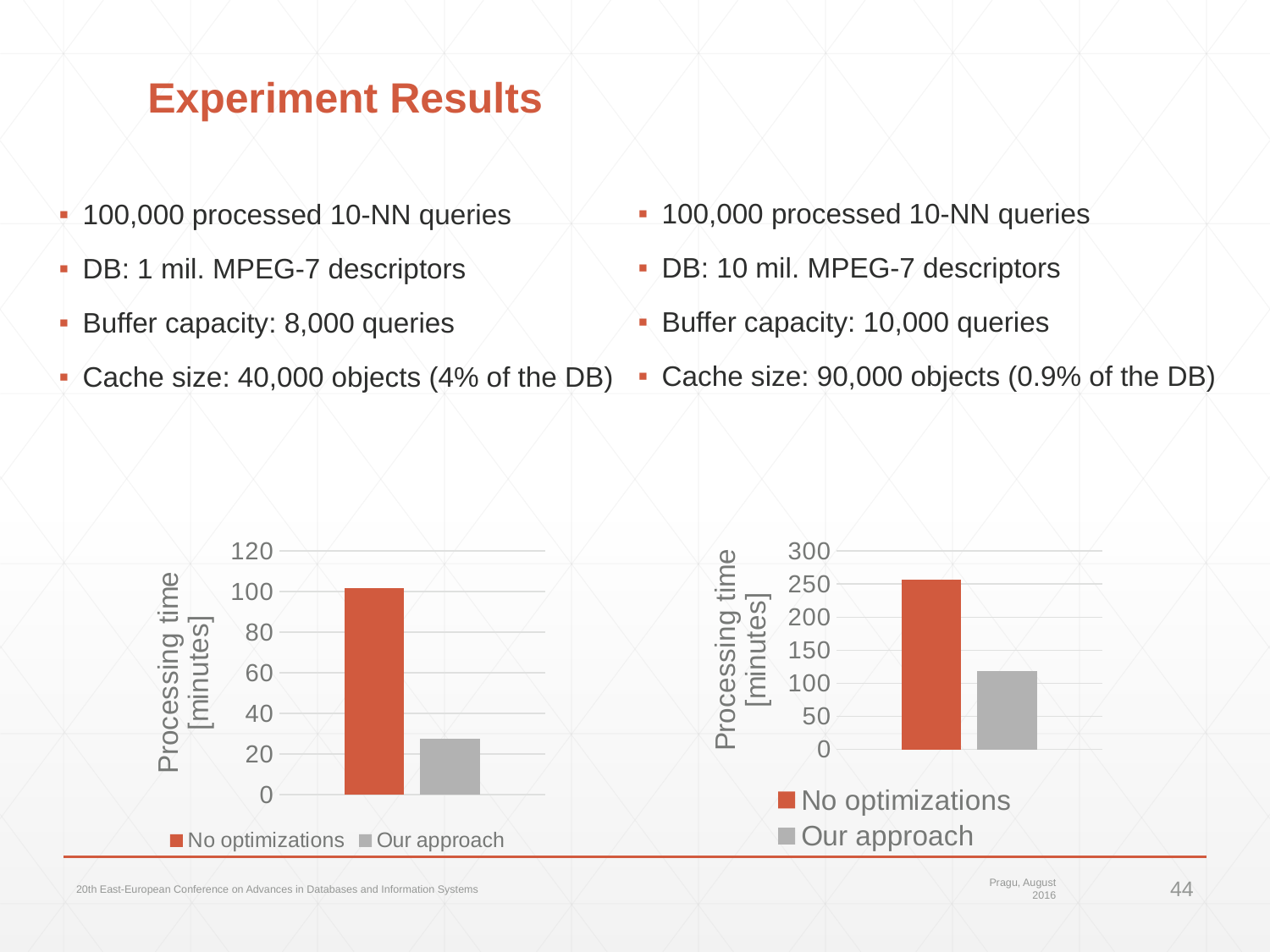
In the right chart, is the value for Our approach greater or less than 150? less In the left chart, what kind of chart is shown? bar chart In the right chart, how many series does the legend list? 2 In the left chart, what colour is the bar for Our approach? grey In the right chart, which series has the shorter bar? Our approach In the left chart, which series has the taller bar, No optimizations or Our approach? No optimizations In the left chart, what is the highest value shown on the vertical axis? 120 In the right chart, how many bars are plotted? 2 In the right chart, what is the label of the vertical axis? Processing time [minutes] In the left chart, is the value for Our approach greater or less than 40? less In the right chart, is the value for No optimizations greater or less than 200? greater